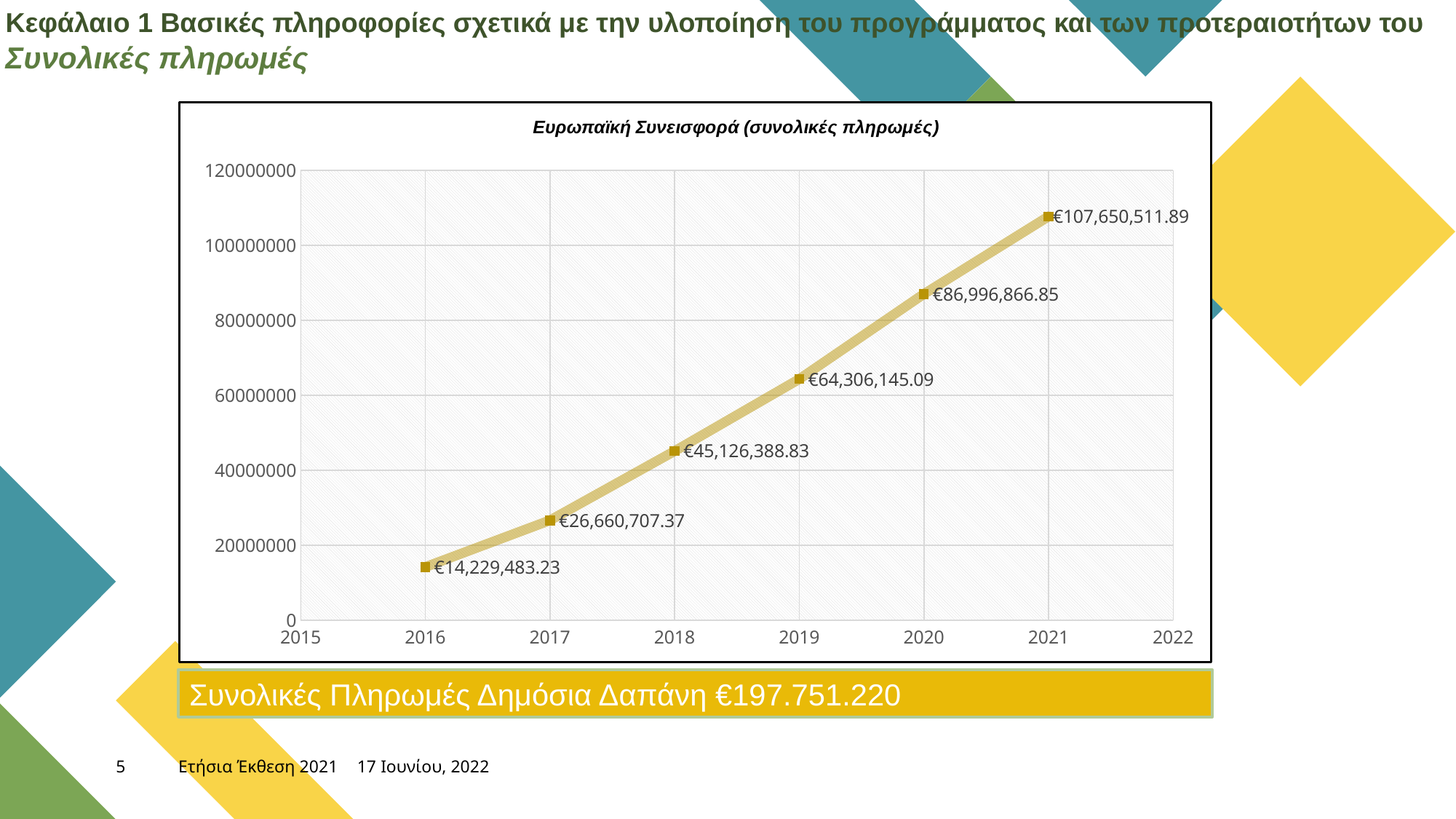
Do the values rise or fall from 2016 to 2021? rise What kind of chart is shown? line chart Which year has the highest value? 2021 Which is larger, the value for 2018 or the value for 2020? 2020 What is the difference between the values for 2021 and 2020? €20,653,645.04 How many data points are plotted on the chart? 6 What is the value for 2019? €64,306,145.09 Is the value for 2019 greater or less than 60000000? greater Which year has the lowest value? 2016 What is the difference between the values for 2017 and 2016? €12,431,224.14 What is the value for 2016? €14,229,483.23 What is the value for 2021? €107,650,511.89